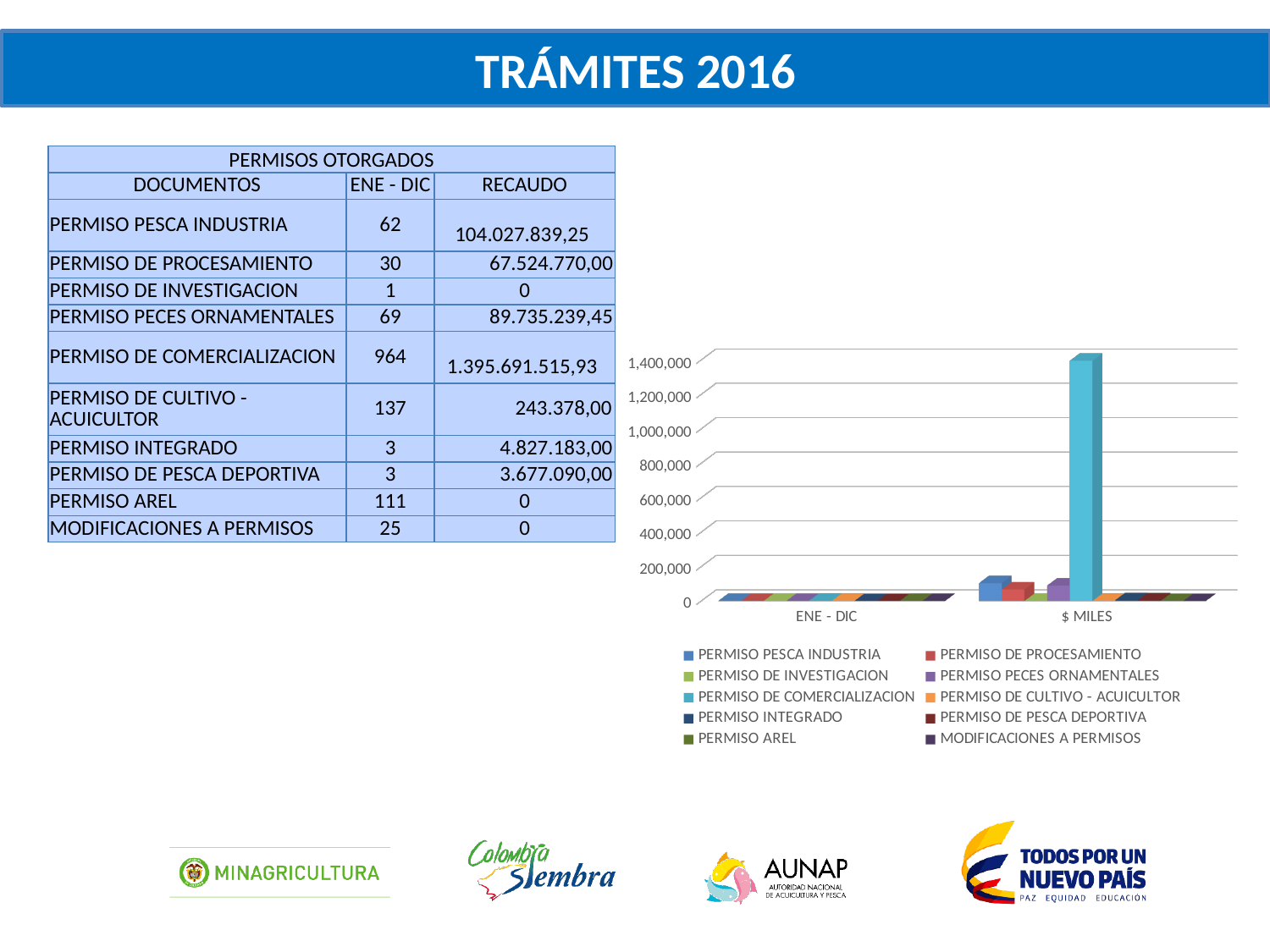
How many series does the chart legend list? 10 What are the two category labels on the x axis of the chart? ENE - DIC and $ MILES How many categories are shown on the x axis of the chart? 2 Is the value for PERMISO PESCA INDUSTRIA in the $ MILES category greater or less than 200,000? less Is the value for PERMISO DE PROCESAMIENTO in the $ MILES category greater or less than 400,000? less Is the value for PERMISO DE COMERCIALIZACION in the $ MILES category greater or less than 1,200,000? greater What kind of chart is shown on the right of the slide? bar chart Which series has the tallest bar in the $ MILES category? PERMISO DE COMERCIALIZACION In the $ MILES category, which is larger: PERMISO DE COMERCIALIZACION or PERMISO PECES ORNAMENTALES? PERMISO DE COMERCIALIZACION What is the highest tick value shown on the chart's vertical axis? 1,400,000 In the $ MILES category, which is larger: PERMISO DE COMERCIALIZACION or PERMISO PESCA INDUSTRIA? PERMISO DE COMERCIALIZACION